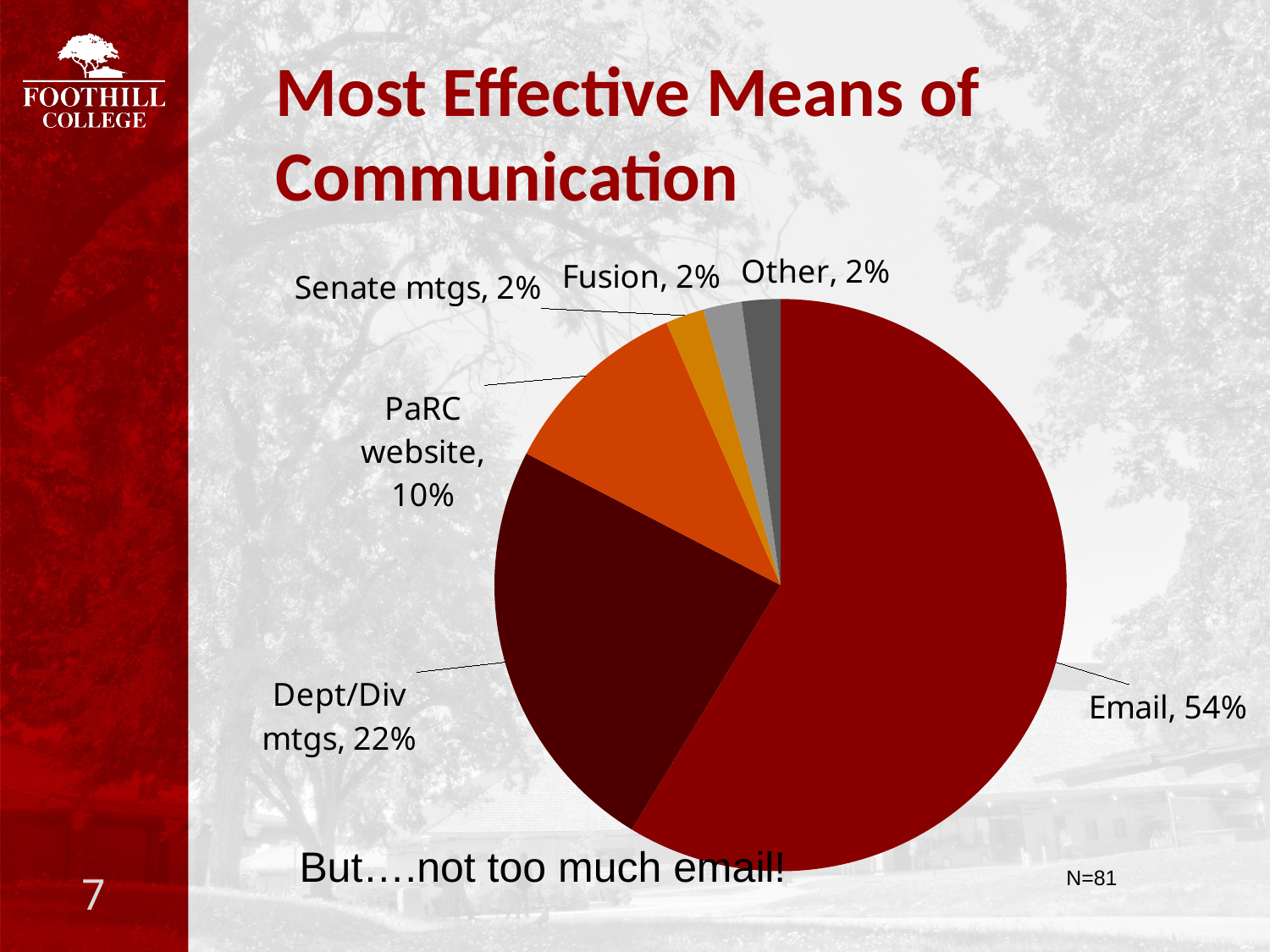
Which is larger, the share for Dept/Div mtgs or the share for PaRC website? Dept/Div mtgs How many slices does the pie chart have? 6 What is the title of the chart? Most Effective Means of Communication What is the value for Senate mtgs? 2% What is the difference between the Email share and the Dept/Div mtgs share? 32 percentage points What type of chart is shown on the slide? pie chart Which category has the largest slice of the pie? Email What share of the pie does Email account for? 54% What is the combined share of Dept/Div mtgs and PaRC website? 32% What sample size (N) is noted on the slide? N=81 What is the value for Dept/Div mtgs? 22% What is the value for PaRC website? 10%